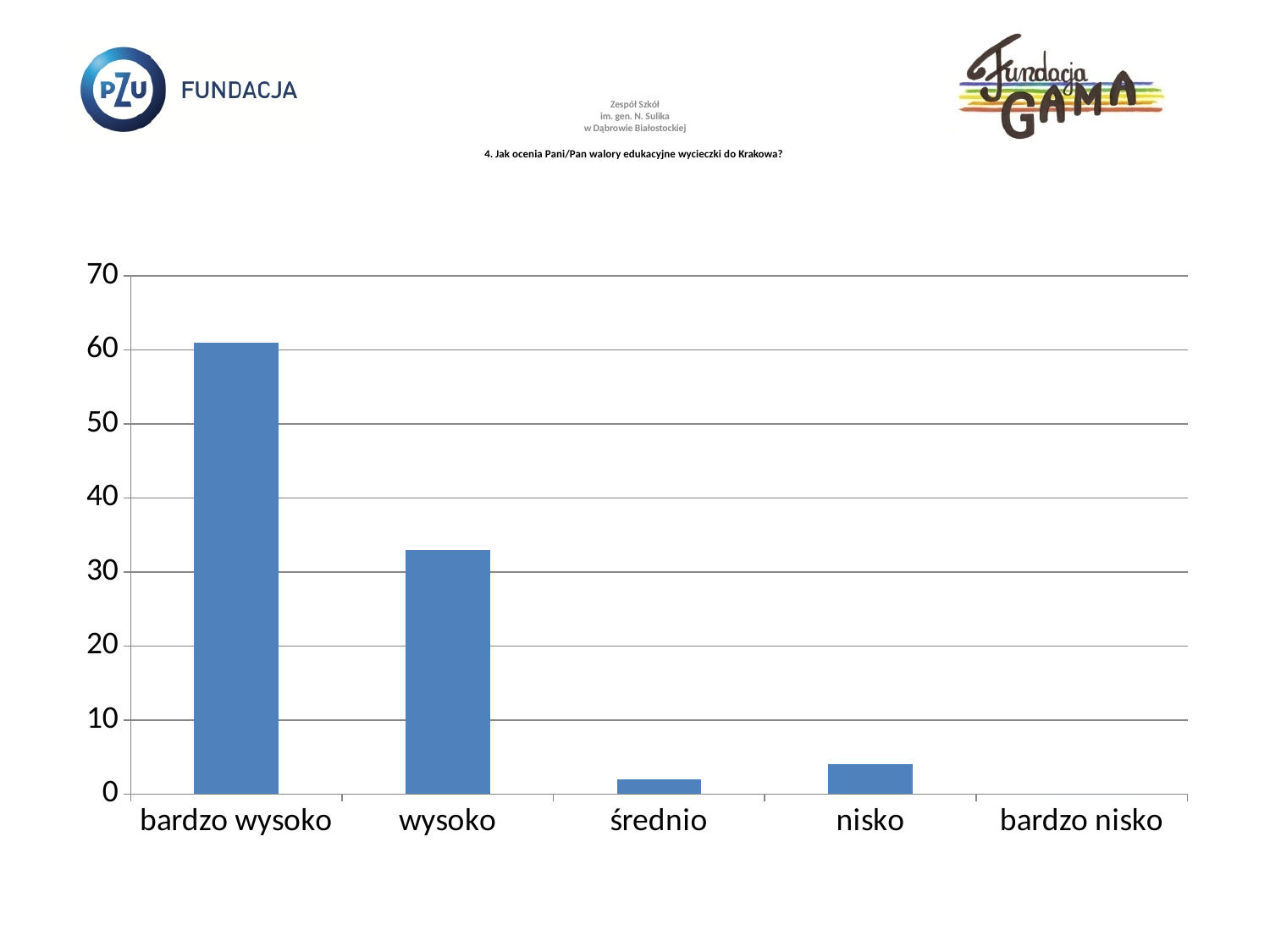
Which category has the lowest value in the chart? bardzo nisko What kind of chart is shown on the slide? bar chart Which is larger, the value for nisko or the value for średnio? nisko Is the value for wysoko greater or less than 30? greater How many categories are shown on the x axis of the chart? 5 Is the value for średnio greater or less than 10? less Which is larger, the value for bardzo wysoko or the value for wysoko? bardzo wysoko Which category has the highest bar? bardzo wysoko What is the title of the chart? 4. Jak ocenia Pani/Pan walory edukacyjne wycieczki do Krakowa? Is the value for wysoko greater or less than 40? less